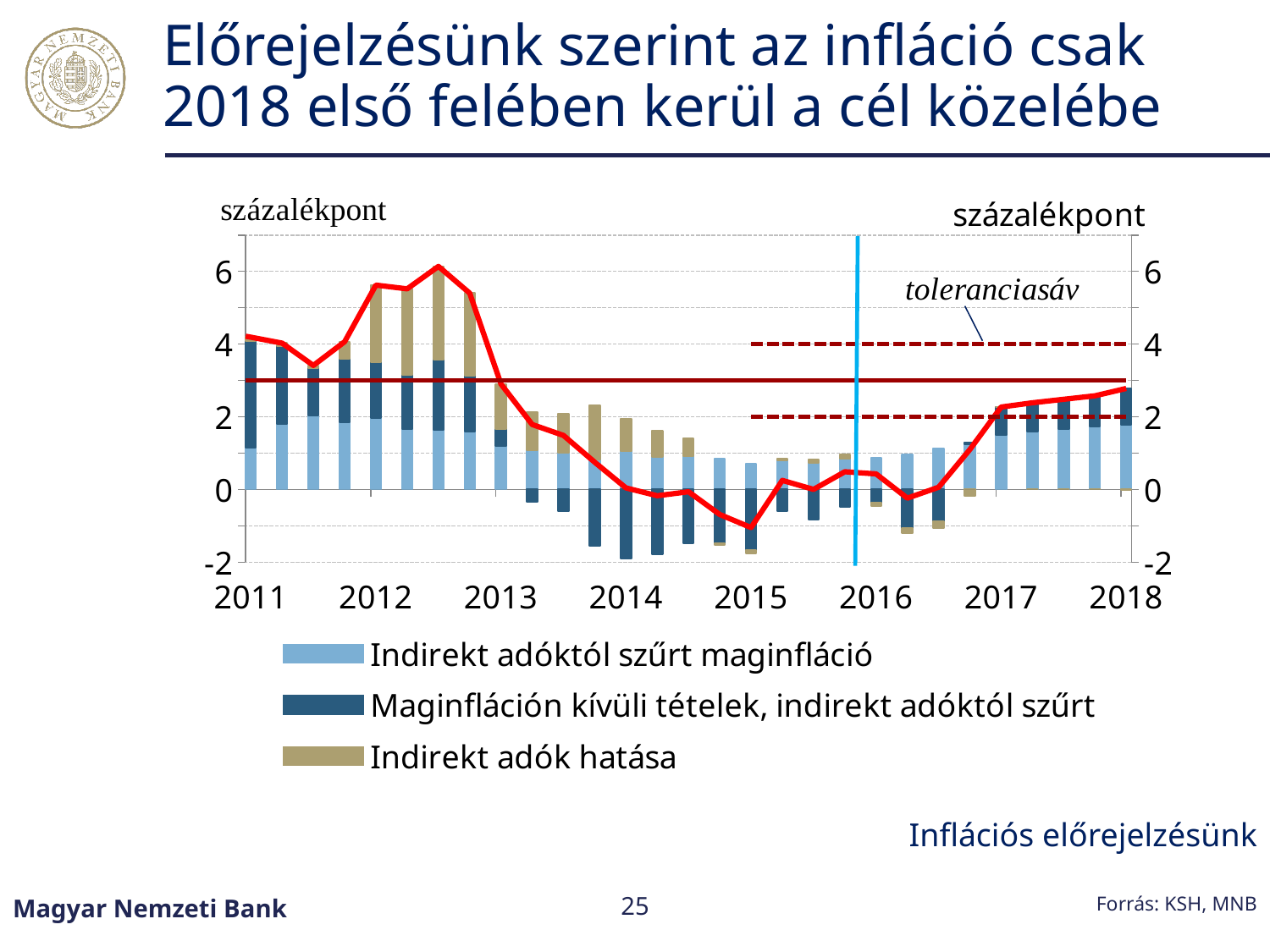
Which legend entry is shown in the lightest blue colour? Indirekt adóktól szűrt maginfláció How many year labels are shown on the x axis? 8 Is the value of the red inflation line at the start of 2014 greater or less than 2? less Does the red inflation line rise or fall between 2013 and 2015? fall Is the value of the red inflation line at the start of 2018 greater or less than 2? greater Is the value of the red inflation line at the start of 2013 greater or less than 2? greater What kind of chart is shown on the slide? bar chart (stacked) with a line What is the unit shown on the vertical axes of the chart? százalékpont How many series does the legend list? 3 In which year does the red inflation line reach its highest value? 2012 Does the red inflation line rise or fall between 2016 and 2018? rise